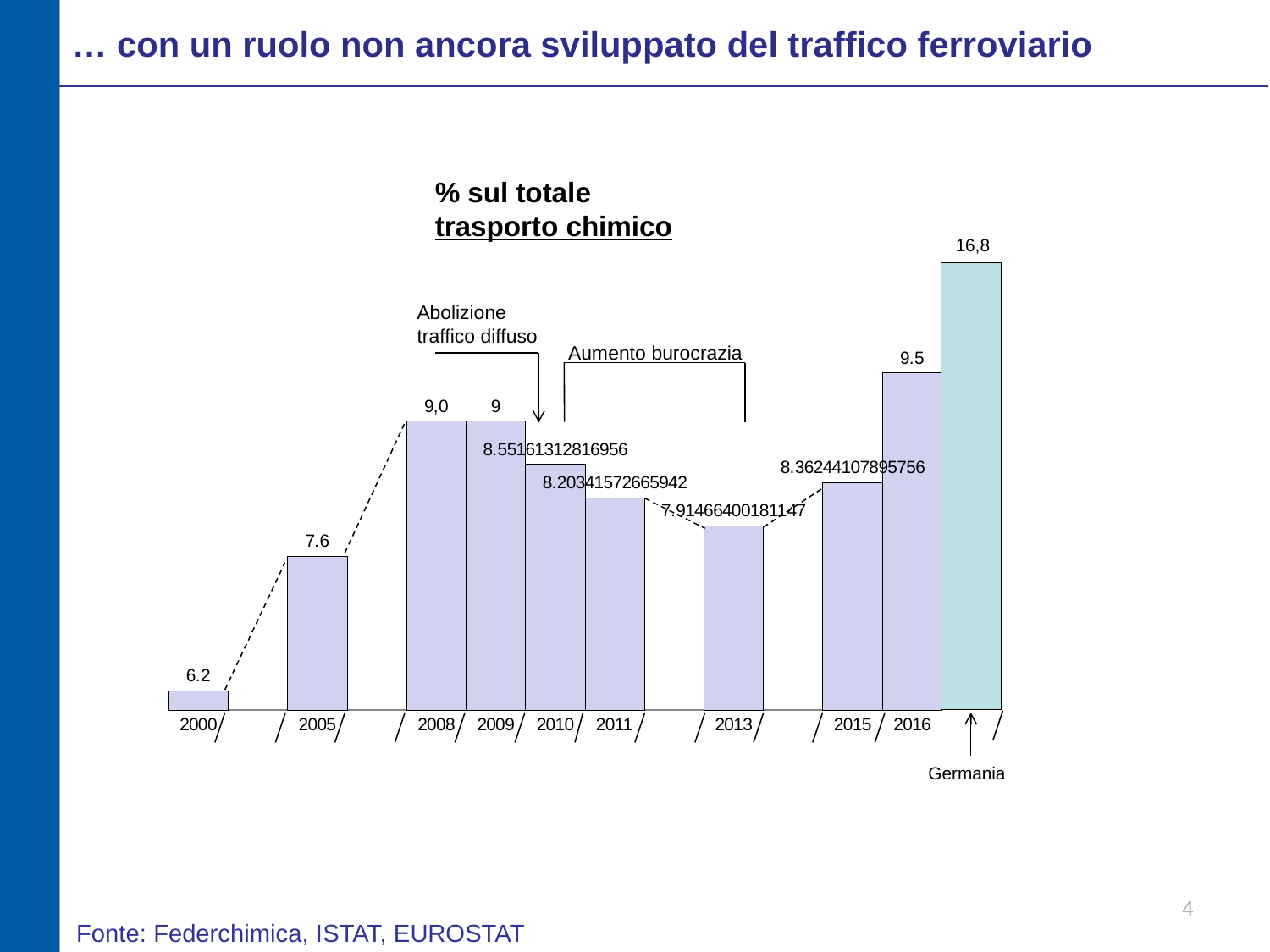
What is the value for 2016? 9.5 What is the value for 2000? 6.2 What is the value for Germania? 16,8 Which bar has the highest value? Germania What is the value for 2005? 7.6 Which is larger, the value for 2005 or the value for 2015? 2015 How many bars are plotted in the chart? 10 What kind of chart is shown on the slide? bar chart What is the title of the chart? % sul totale trasporto chimico Which year has the lowest value? 2000 Do the values rise or fall from 2009 to 2013? fall What is the difference between the value for 2016 and the value for 2000? 3.3